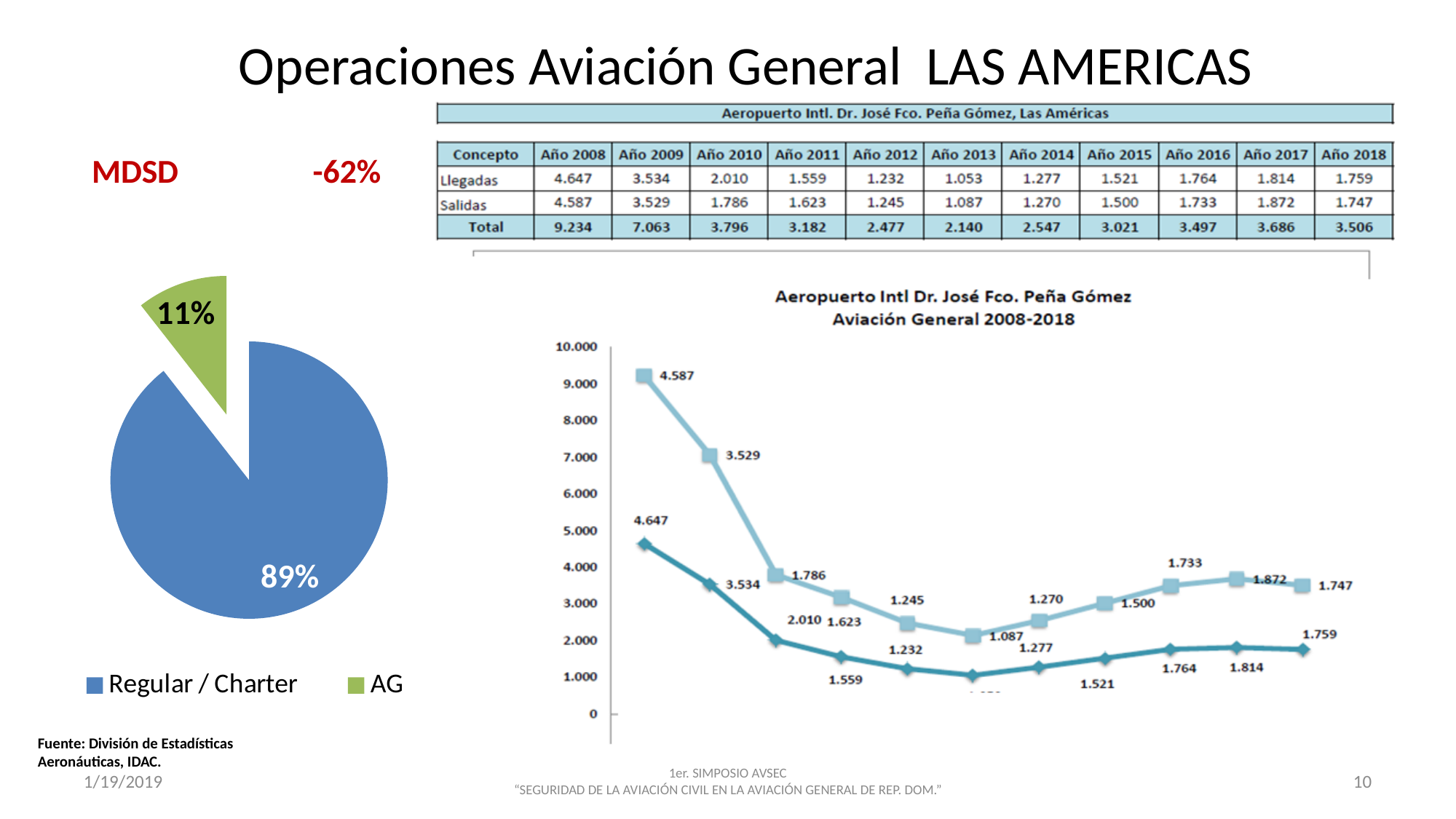
How many entries does the legend of the pie chart list? 2 In the line chart 'Aviación General 2008-2018', what is the difference between the first labelled values of the two lines, 4.647 and 4.587? 60 What kind of chart is the chart on the left of the slide? Pie chart In the line chart 'Aviación General 2008-2018', do the values of the lighter line rise or fall from the first point to the last point? Fall In the line chart 'Aviación General 2008-2018', what is the lowest labelled value on the lighter (upper) line? 1.087 In the line chart 'Aviación General 2008-2018', how many data points does each line have? 11 In the pie chart, what share does Regular / Charter have? 89% In the line chart 'Aviación General 2008-2018', what is the last labelled value on the darker (lower) line? 1.759 In the pie chart, which slice is larger, Regular / Charter or AG? Regular / Charter In the line chart 'Aviación General 2008-2018', what is the highest labelled value? 4.647 In the pie chart, what share does AG have? 11% What kind of chart is the chart titled 'Aviación General 2008-2018'? Line chart